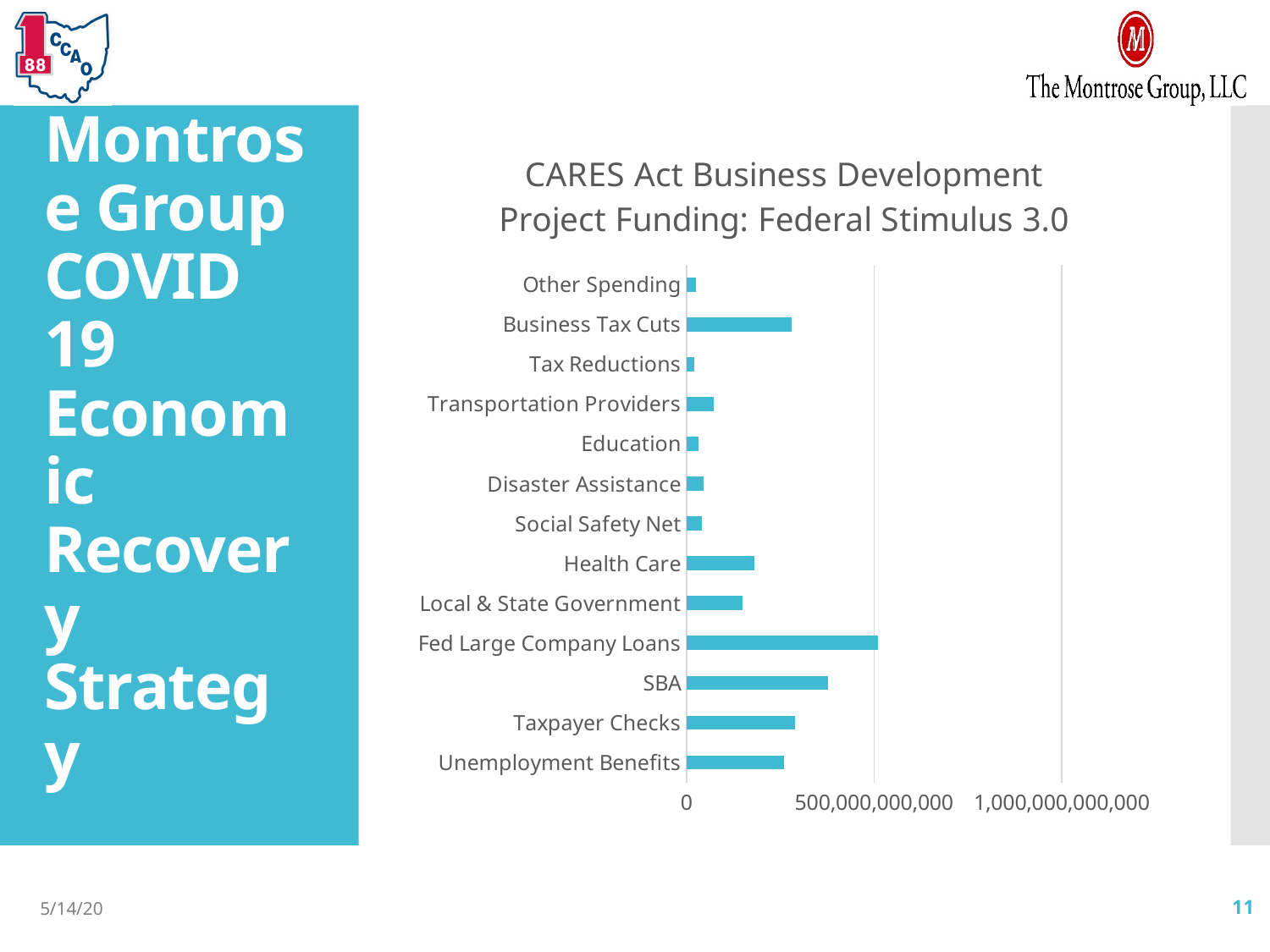
Which category has the highest value in the chart? Fed Large Company Loans Is the value for Business Tax Cuts greater or less than 500,000,000,000? less What is the title of the chart? CARES Act Business Development Project Funding: Federal Stimulus 3.0 Which is larger, the value for Fed Large Company Loans or the value for SBA? Fed Large Company Loans How many categories are plotted in the chart? 13 Which is larger, the value for Transportation Providers or the value for Education? Transportation Providers What is the highest value labelled on the horizontal axis of the chart? 1,000,000,000,000 Is the value for SBA greater or less than 500,000,000,000? less Which is larger, the value for Health Care or the value for Local & State Government? Health Care Is the value for Fed Large Company Loans greater or less than 1,000,000,000,000? less What kind of chart is shown on the slide? Bar chart